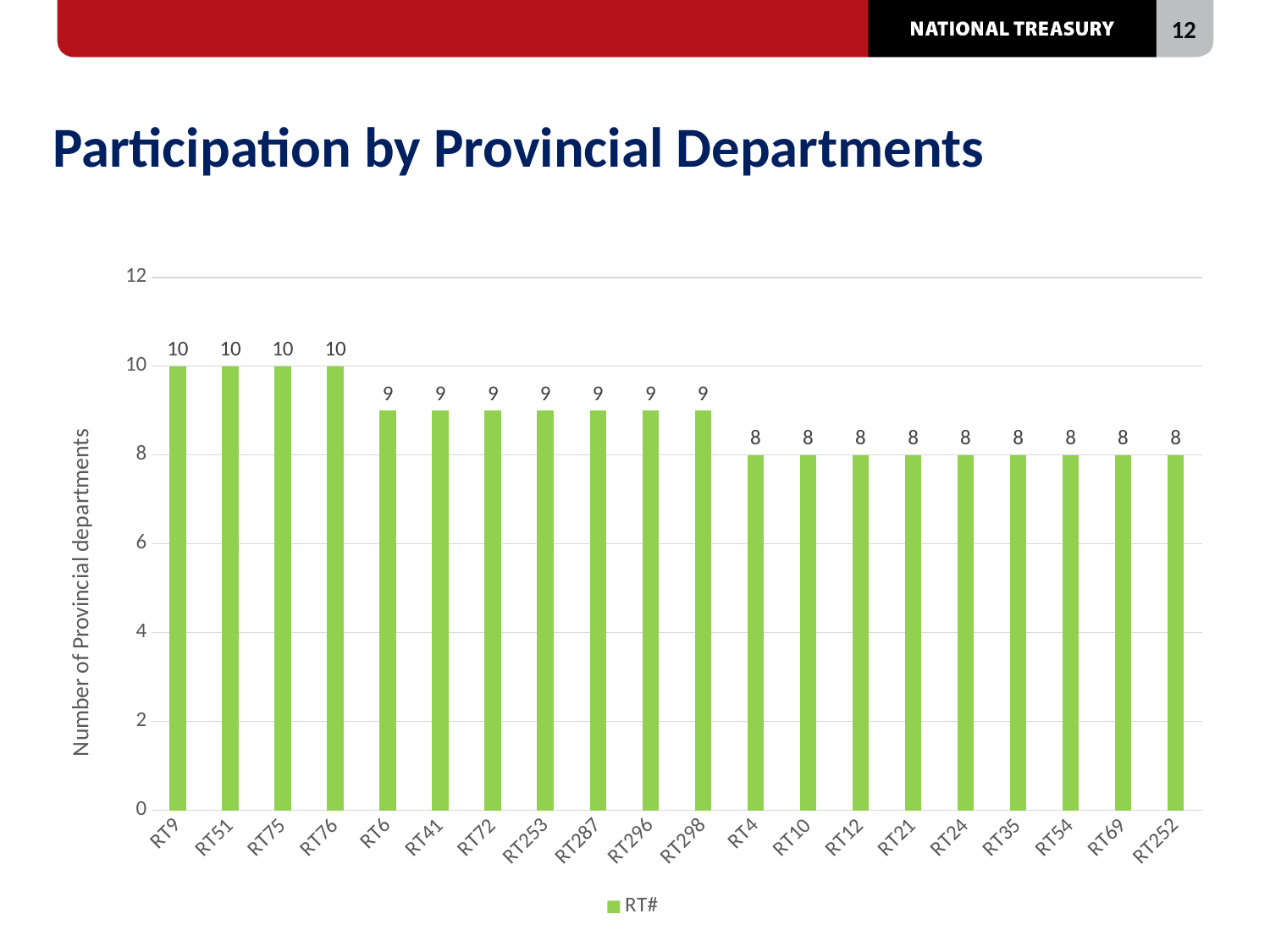
What is the lowest value shown on the chart? 8 How many series does the legend list? 1 What kind of chart is shown on the slide? bar chart Is the value for RT41 greater or less than 6? greater What is the label of the y axis? Number of Provincial departments Which has a larger value, RT6 or RT10? RT6 What is the difference between the values for RT76 and RT4? 2 How many categories are shown on the x axis? 20 What is the value for RT252? 8 What is the value for RT9? 10 What is the highest value shown on the chart? 10 What is the value for RT253? 9